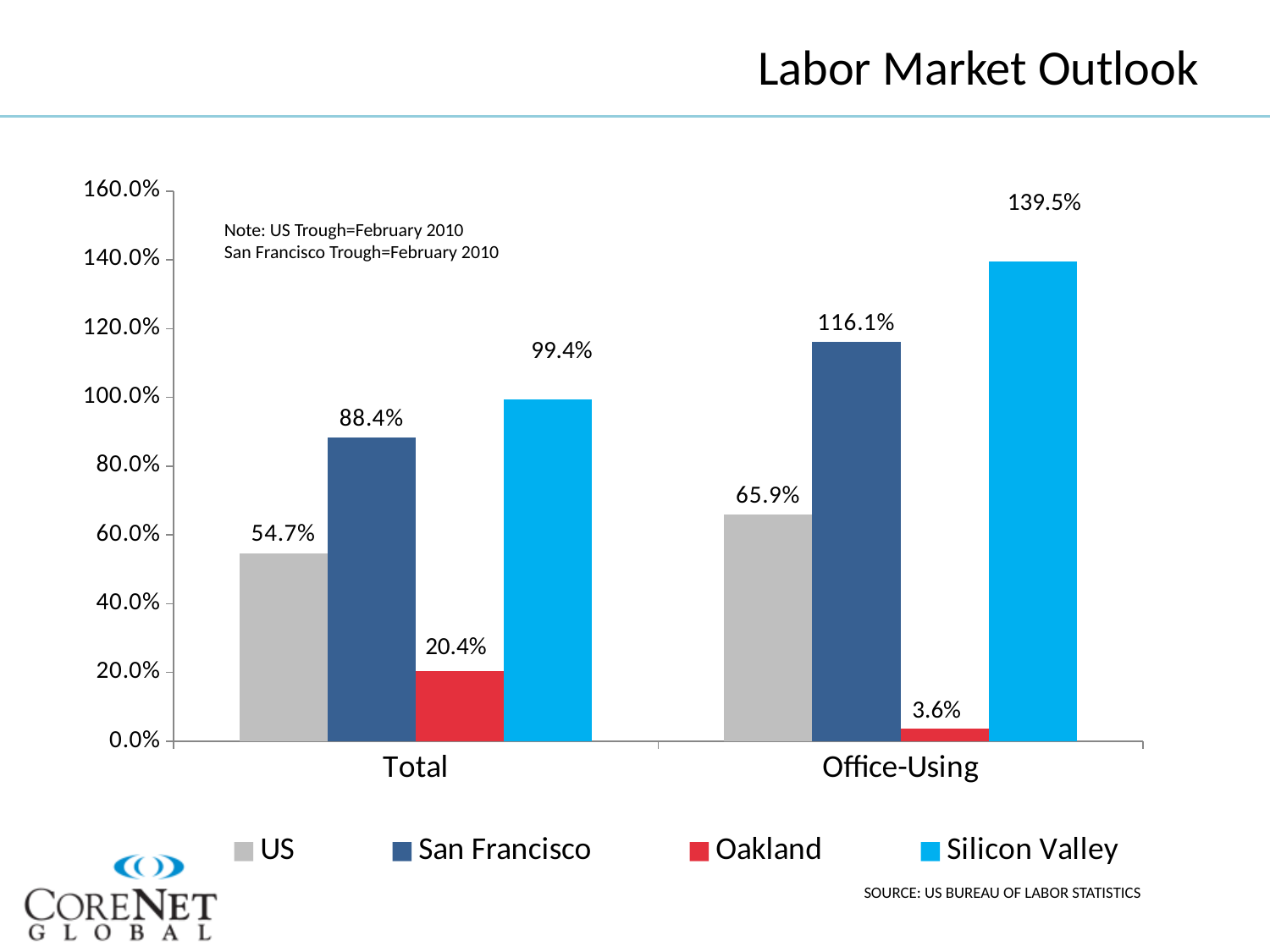
What kind of chart is shown on the slide? Bar chart Is the value for San Francisco in the Total category greater or less than 100.0%? less Which series has the highest value in the Total category? Silicon Valley What is the difference between San Francisco's Office-Using value and its Total value? 27.7% What is the value for Oakland in the Total category? 20.4% Which is larger: the US value for Total or the US value for Office-Using? Office-Using How many categories are shown on the x axis? 2 What is the title of the slide? Labor Market Outlook What is the value for US in the Office-Using category? 65.9% How many series does the legend list? 4 Which series has the lowest value in the Office-Using category? Oakland What is the value for Silicon Valley in the Office-Using category? 139.5%